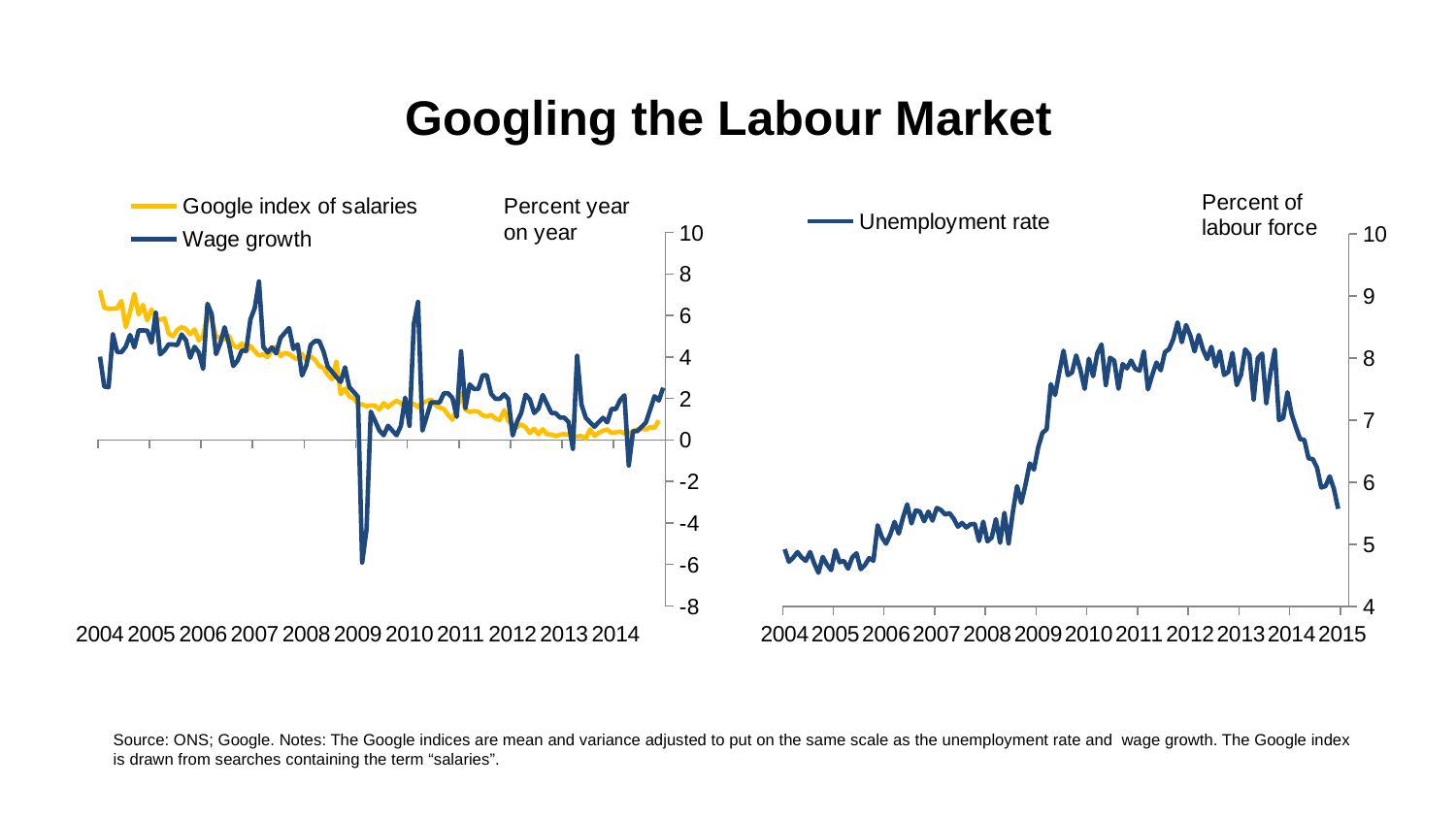
In the left chart, is the Google index of salaries at the start of 2004 greater or less than 4? greater In the left chart, is the lowest point of wage growth in 2009 greater or less than -4? less What kind of chart is the left chart, with the Google index of salaries and wage growth? Line chart In the right chart, does the unemployment rate rise or fall between 2008 and 2010? rise In the right chart, does the unemployment rate rise or fall between 2013 and 2015? fall In the left chart, does the Google index of salaries rise or fall between 2004 and 2013? fall In the right chart, is the unemployment rate at the start of 2004 greater or less than 6? less In the right chart, what unit label is shown above the y axis? Percent of labour force How many series does the legend of the right chart list? 1 How many series does the legend of the left chart list? 2 In the left chart, which two series are listed in the legend? Google index of salaries and Wage growth